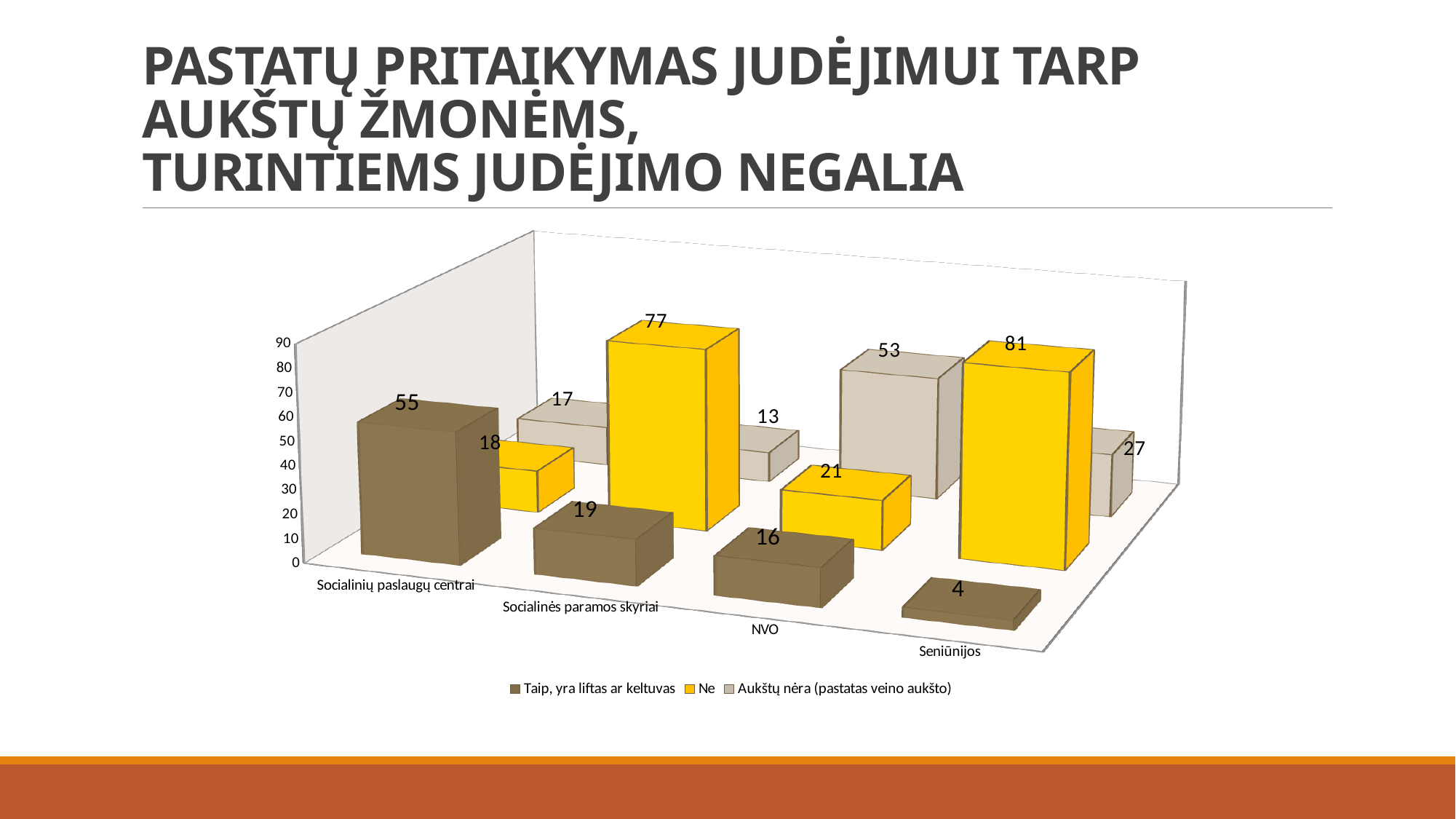
How many categories are shown on the x axis? 4 Which category has the highest value for "Ne"? Seniūnijos Which is larger: the "Aukštų nėra (pastatas veino aukšto)" value for NVO or for Seniūnijos? NVO What is the total of the three values for NVO? 90 What is the value for "Aukštų nėra (pastatas veino aukšto)" for NVO? 53 What kind of chart is shown on the slide? Bar chart What is the difference between the "Ne" values for Seniūnijos and Socialinės paramos skyriai? 4 What is the value for "Ne" for Socialinės paramos skyriai? 77 How many series does the legend list? 3 What is the value for "Taip, yra liftas ar keltuvas" for Socialinių paslaugų centrai? 55 What is the value for "Taip, yra liftas ar keltuvas" for Seniūnijos? 4 Which category has the lowest value for "Taip, yra liftas ar keltuvas"? Seniūnijos